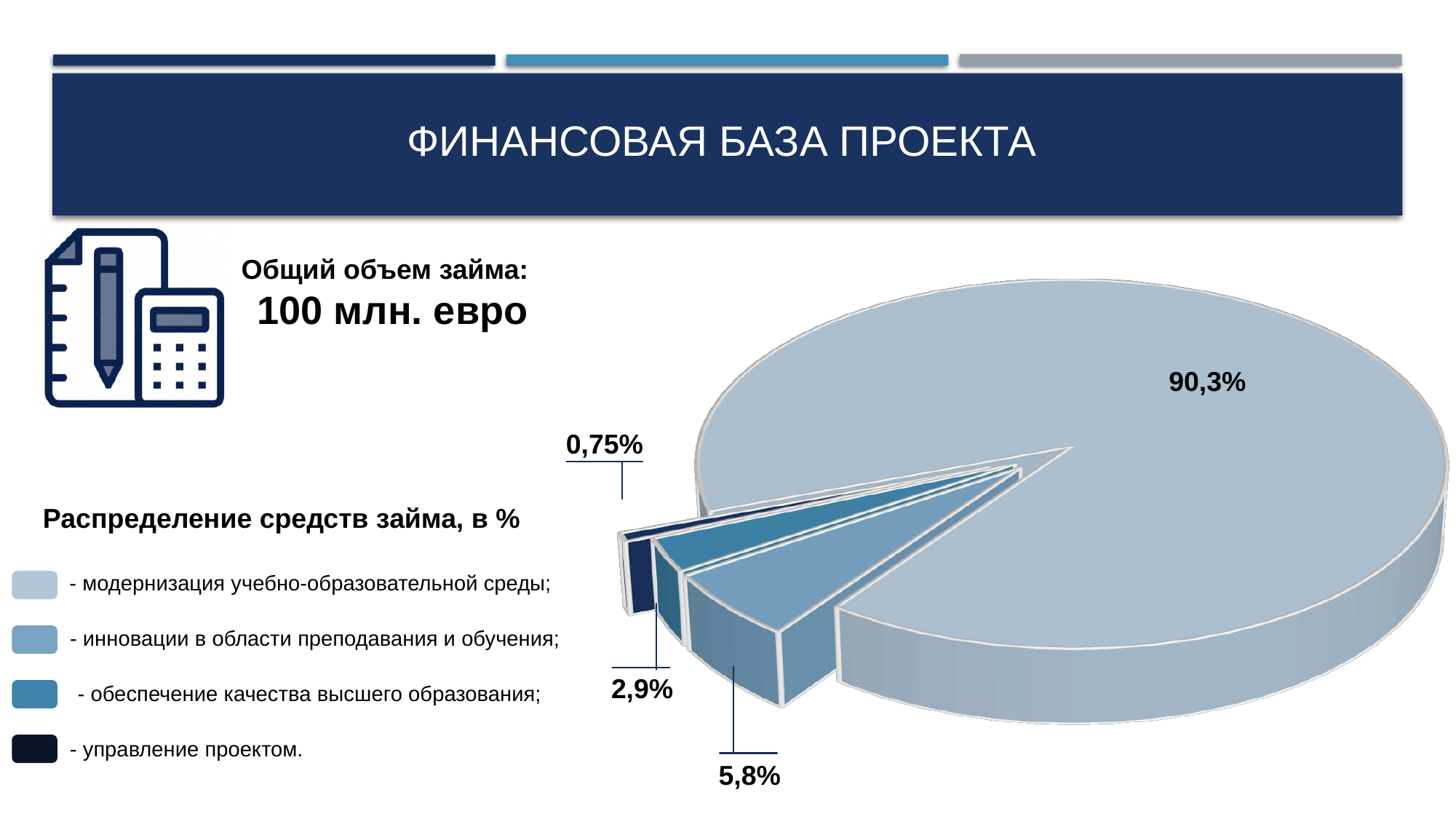
Which is larger: the share for инновации в области преподавания и обучения or the share for обеспечение качества высшего образования? инновации в области преподавания и обучения What is the total loan amount stated on the slide? 100 млн. евро Which category has the largest share of the pie? модернизация учебно-образовательной среды Which category has the smallest share of the pie? управление проектом What share of the loan funds goes to инновации в области преподавания и обучения? 5,8% What share of the loan funds goes to обеспечение качества высшего образования? 2,9% What kind of chart is shown on the slide? pie chart How many slices does the pie chart have? 4 What is the difference between the share for инновации в области преподавания и обучения and the share for обеспечение качества высшего образования? 2,9% What is the difference between the share for обеспечение качества высшего образования and the share for управление проектом? 2,15% What share of the loan funds goes to управление проектом? 0,75% What share of the loan funds goes to модернизация учебно-образовательной среды? 90,3%